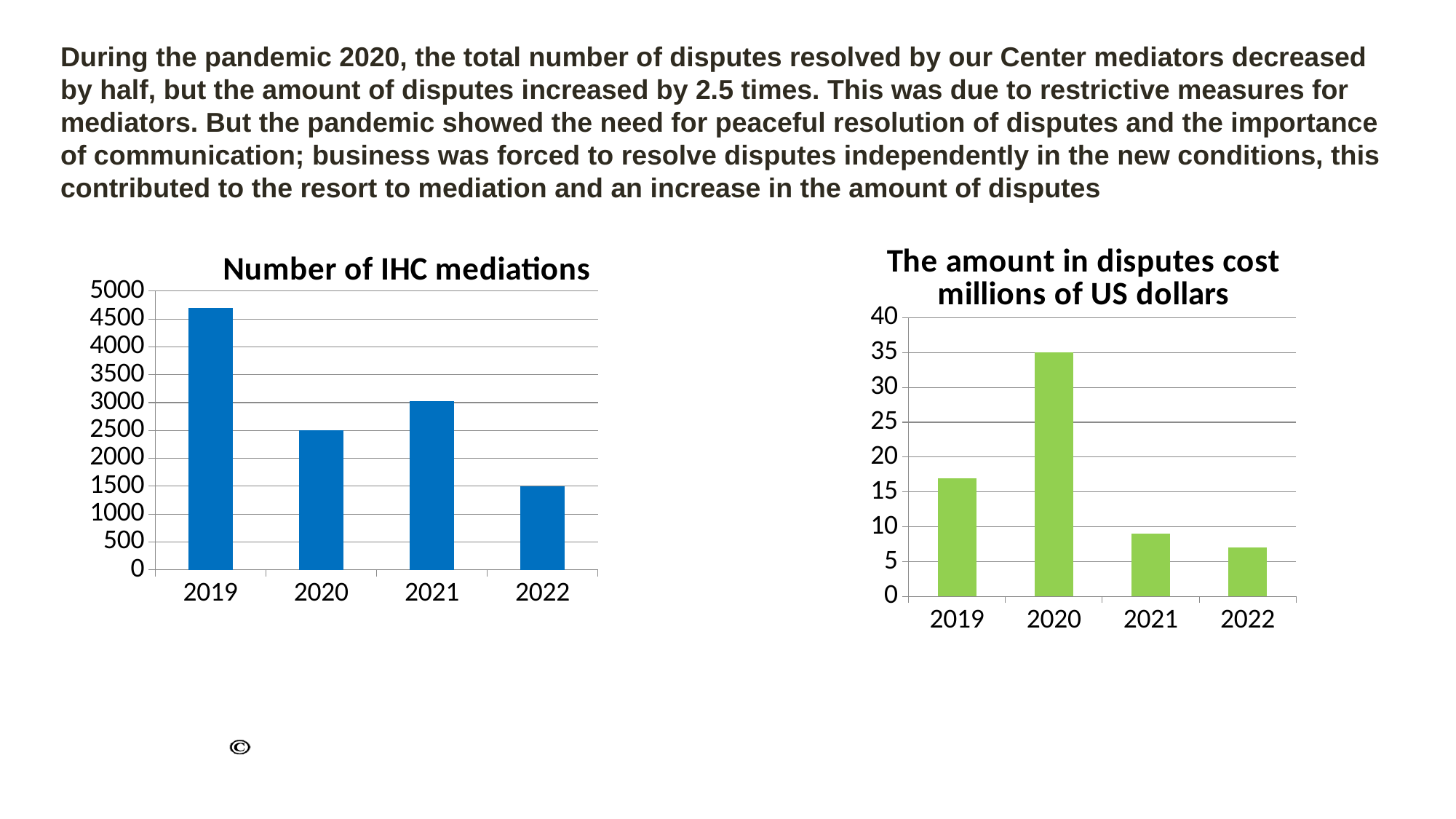
In the 'Number of IHC mediations' chart, which year has the lowest value? 2022 In the 'Number of IHC mediations' chart, what is the value for 2022? 1500 In the 'Number of IHC mediations' chart, what is the value for 2020? 2500 In the 'The amount in disputes cost millions of US dollars' chart, what is the value for 2020? 35 In the 'Number of IHC mediations' chart, which is larger, the value for 2021 or the value for 2020? 2021 In the 'Number of IHC mediations' chart, is the value for 2019 greater or less than 4500? greater In the 'Number of IHC mediations' chart, what is the difference between the values for 2020 and 2022? 1000 In the 'The amount in disputes cost millions of US dollars' chart, is the value for 2021 greater or less than 10? less In the 'Number of IHC mediations' chart, which year has the highest value? 2019 In the 'The amount in disputes cost millions of US dollars' chart, is the value for 2019 greater or less than 15? greater In the 'The amount in disputes cost millions of US dollars' chart, which year has the lowest value? 2022 In the 'The amount in disputes cost millions of US dollars' chart, which year has the highest value? 2020